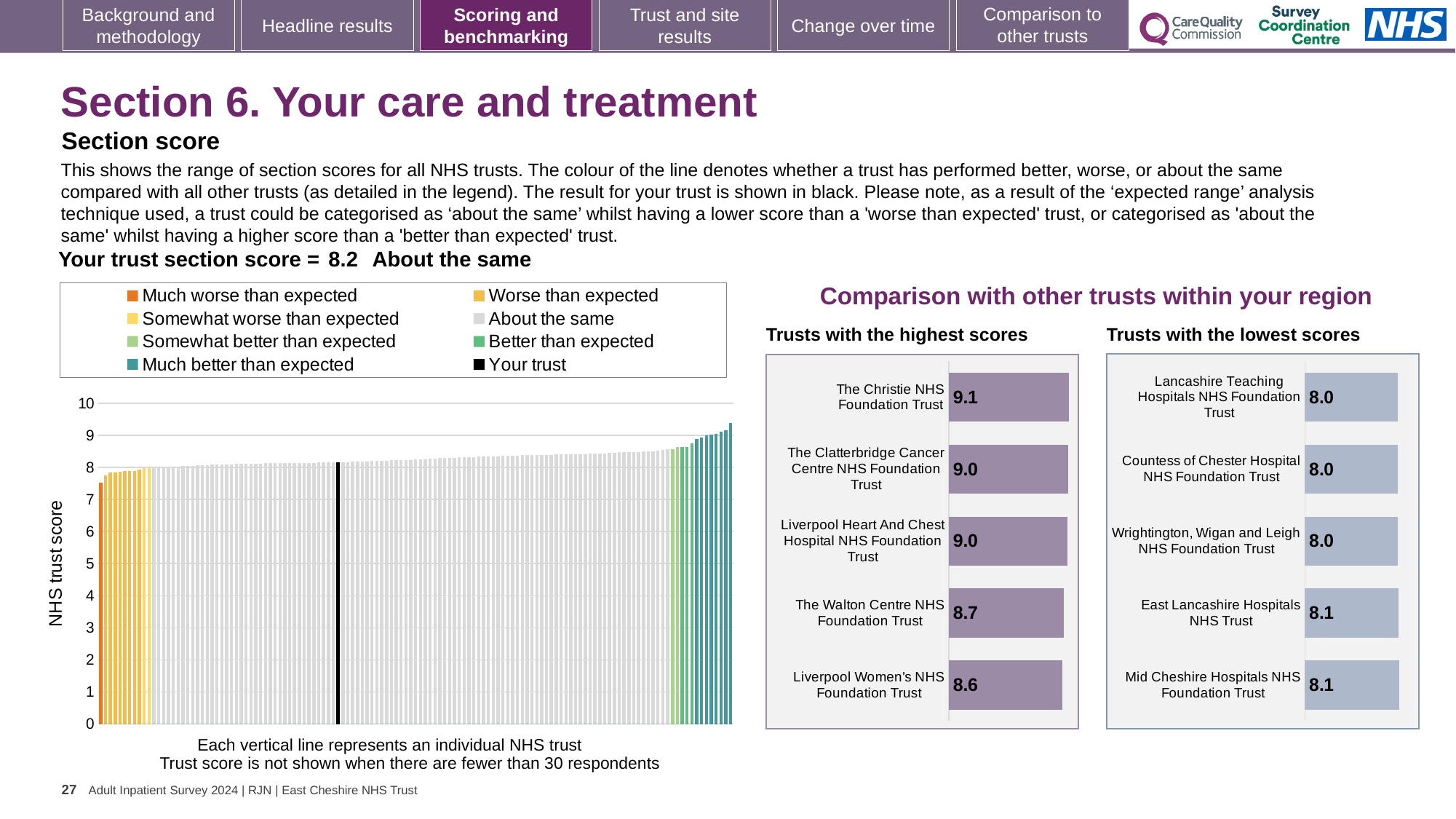
What is the section score for your trust shown on the slide? 8.2 In the 'Trusts with the lowest scores' chart, what is the score for East Lancashire Hospitals NHS Trust? 8.1 What type of chart is the 'Trusts with the highest scores' chart? Bar chart In the 'Trusts with the highest scores' chart, which trust has the lowest score? Liverpool Women's NHS Foundation Trust In the 'Trusts with the highest scores' chart, which trust has the highest score? The Christie NHS Foundation Trust In the 'Trusts with the highest scores' chart, what is the score for The Walton Centre NHS Foundation Trust? 8.7 How many trusts are shown in the 'Trusts with the lowest scores' chart? 5 In the 'Trusts with the highest scores' chart, what is the difference between the scores of The Christie NHS Foundation Trust and Liverpool Women's NHS Foundation Trust? 0.5 How many categories does the legend of the main 'NHS trust score' chart list? 8 In the 'Trusts with the lowest scores' chart, which has the higher score: Mid Cheshire Hospitals NHS Foundation Trust or Countess of Chester Hospital NHS Foundation Trust? Mid Cheshire Hospitals NHS Foundation Trust In the 'Trusts with the highest scores' chart, what is the score for The Christie NHS Foundation Trust? 9.1 In the main 'NHS trust score' chart, is the value of the rightmost (highest) bar greater or less than 9? greater